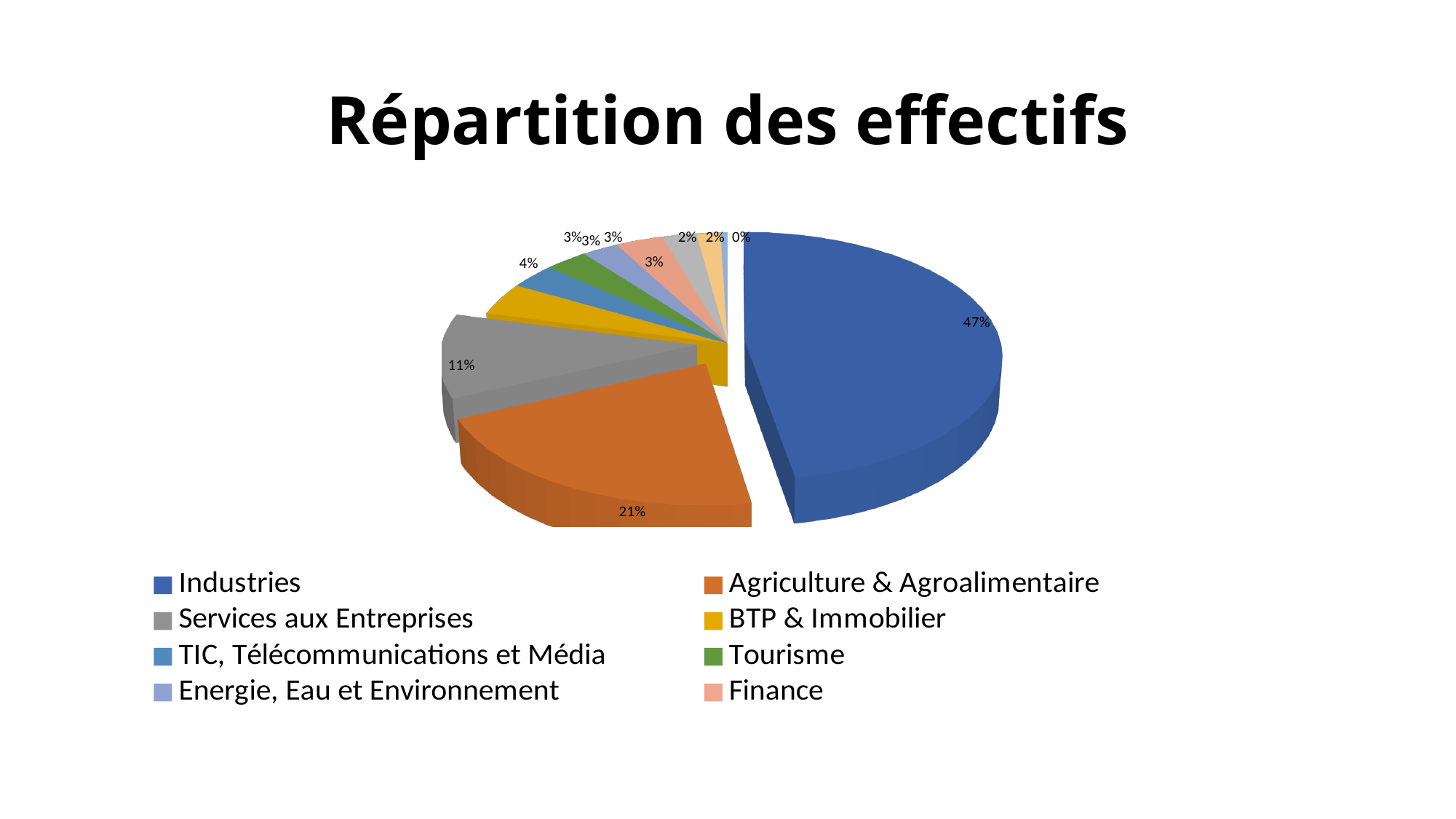
What share of the pie does Industries represent? 47% Which has the larger share: Agriculture & Agroalimentaire or Services aux Entreprises? Agriculture & Agroalimentaire What is the difference in percentage points between the Industries share and the Agriculture & Agroalimentaire share? 26 What share of the pie does Services aux Entreprises represent? 11% What share of the pie does BTP & Immobilier represent? 4% What kind of chart is shown on the slide? pie chart What is the title of the chart? Répartition des effectifs How many categories does the legend list? 8 What share of the pie does Agriculture & Agroalimentaire represent? 21% Which category has the largest share of the pie? Industries What colour is the Industries slice? blue What is the combined share of Industries and Agriculture & Agroalimentaire? 68%